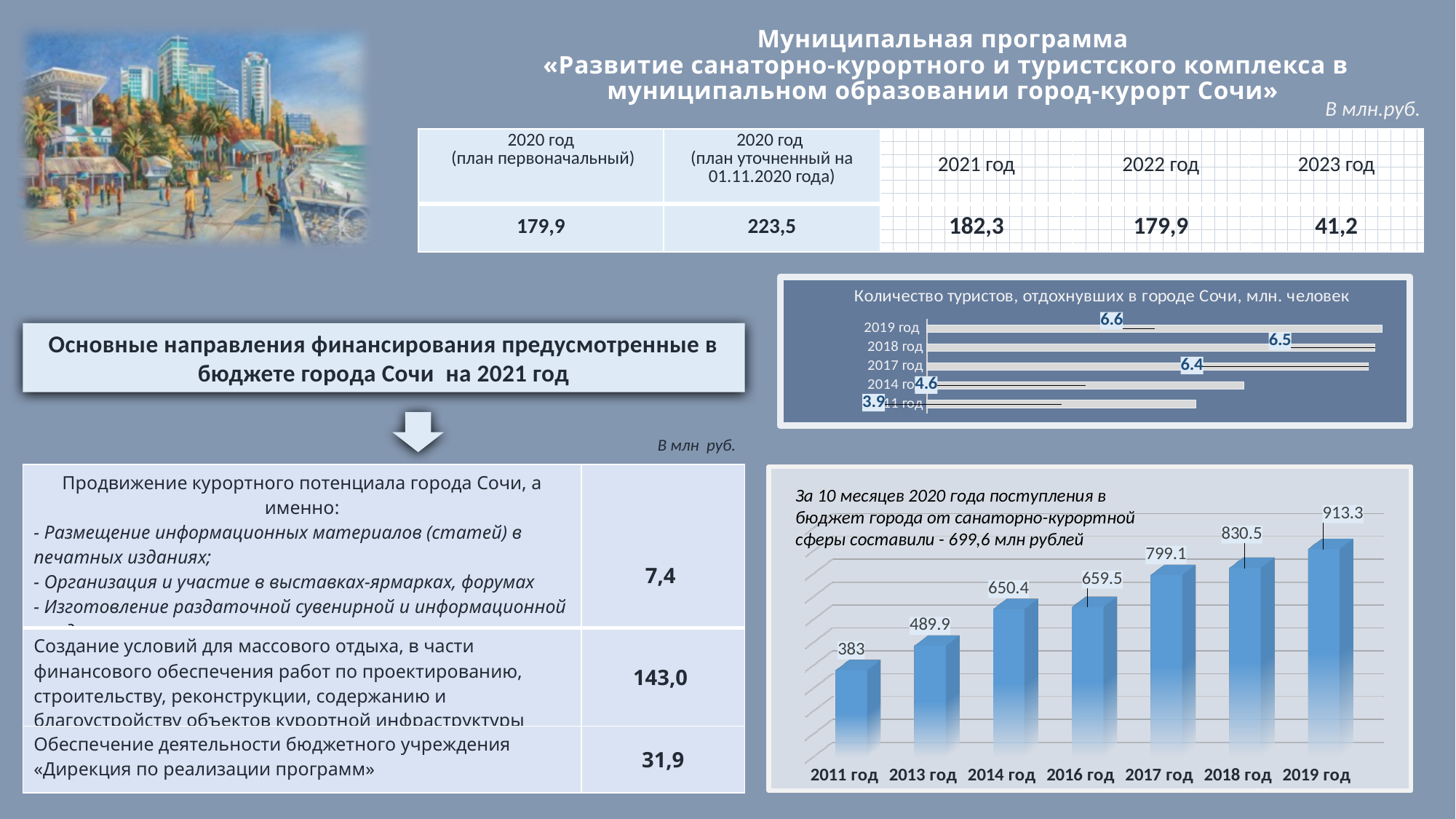
In the chart 'Количество туристов, отдохнувших в городе Сочи, млн. человек', what is the value for 2019 год? 6.6 In the bar chart at the bottom right of the slide, what is the difference between the values for 2019 год and 2018 год? 82.8 What kind of chart is 'Количество туристов, отдохнувших в городе Сочи, млн. человек'? Bar chart In the bar chart at the bottom right of the slide, do the values rise or fall from 2011 год to 2019 год? Rise In the bar chart at the bottom right of the slide, how many bars are there? 7 In the chart 'Количество туристов, отдохнувших в городе Сочи, млн. человек', which year has the lowest value? 2011 год In the chart 'Количество туристов, отдохнувших в городе Сочи, млн. человек', what is the value for 2014 год? 4.6 In the chart 'Количество туристов, отдохнувших в городе Сочи, млн. человек', what is the difference between the values for 2019 год and 2011 год? 2.7 In the bar chart at the bottom right of the slide, what is the value for 2017 год? 799.1 In the chart 'Количество туристов, отдохнувших в городе Сочи, млн. человек', how many years are shown? 5 In the bar chart at the bottom right of the slide, what is the value for 2011 год? 383 In the bar chart at the bottom right of the slide, which year has the highest value? 2019 год